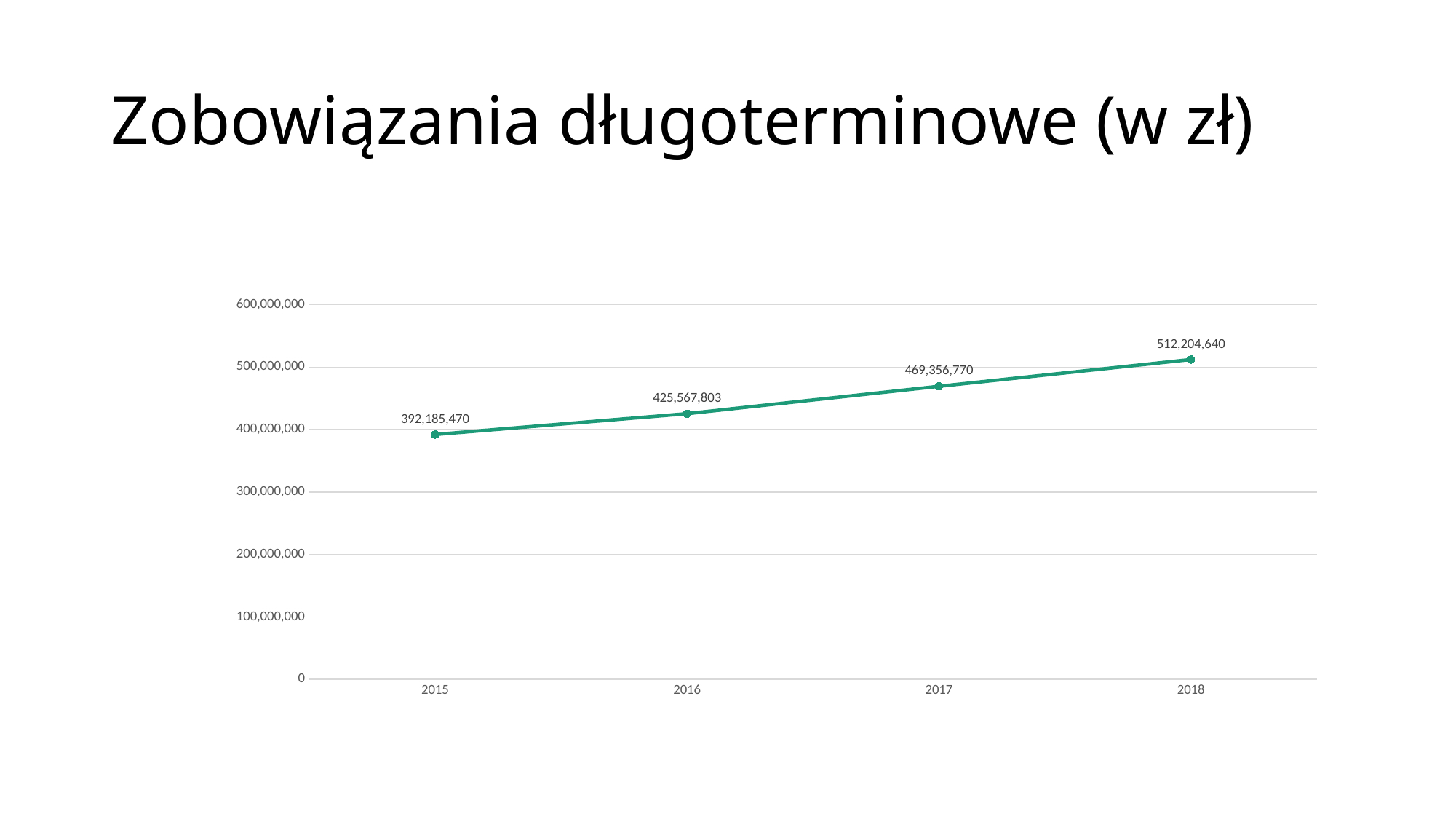
Which year has the lowest value? 2015 What is the value for 2017? 469,356,770 What is the value for 2016? 425,567,803 Is the value for 2018 greater or less than 500,000,000? greater Which is larger, the value for 2016 or the value for 2017? 2017 What kind of chart is shown on the slide? line chart What is the difference between the values for 2017 and 2016? 43,788,967 What is the value for 2018? 512,204,640 Which year has the highest value? 2018 What is the difference between the values for 2018 and 2015? 120,019,170 What is the value for 2015? 392,185,470 How many years are plotted on the chart? 4